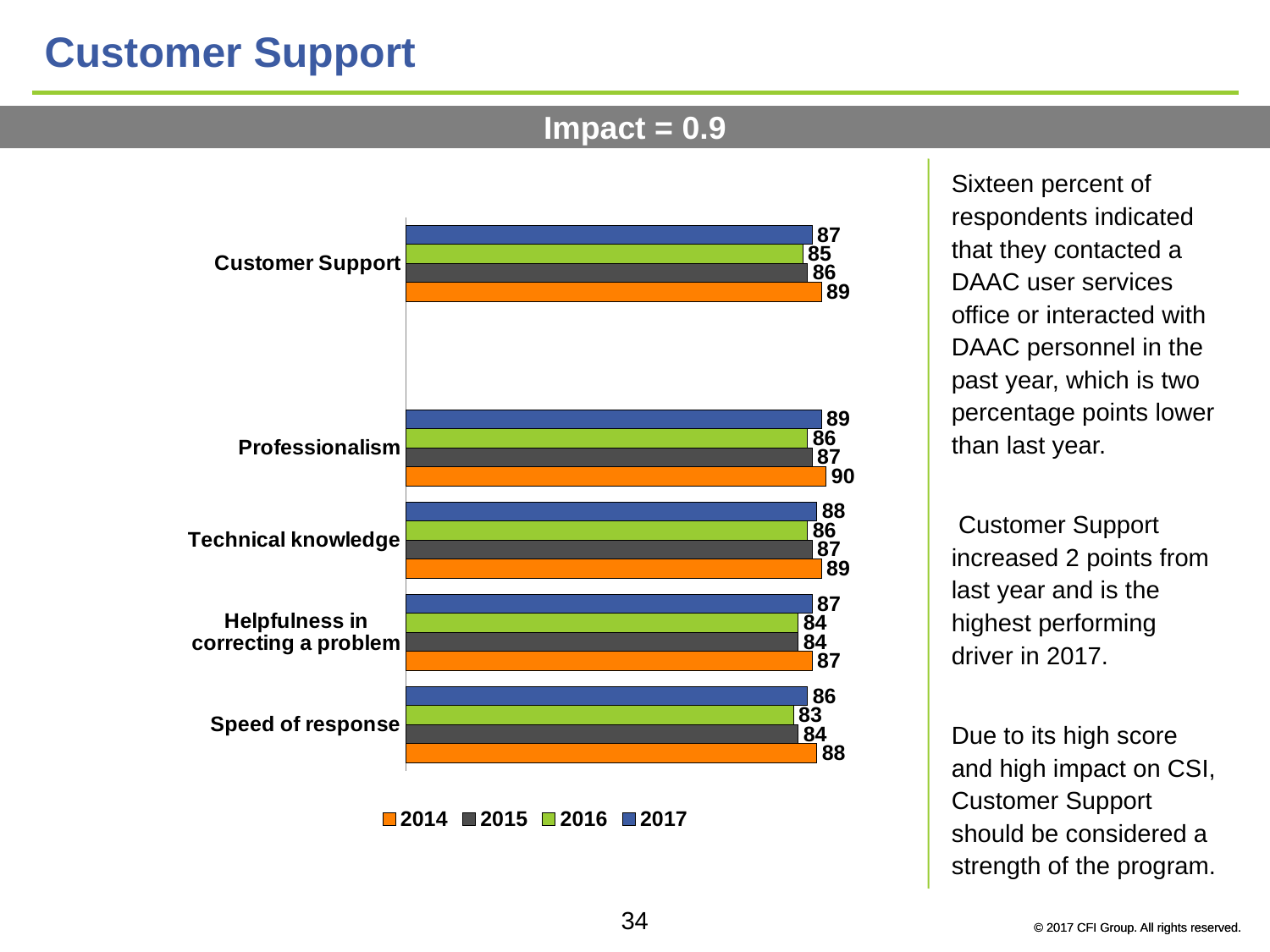
Which category has the highest 2017 value? Professionalism What is the 2014 value for Professionalism? 90 What impact value is shown in the banner above the chart? 0.9 How many series does the legend list? 4 Which is larger for Speed of response, the 2014 value or the 2017 value? 2014 What kind of chart is shown on the slide? Bar chart What is the difference between the 2017 and 2016 values for Helpfulness in correcting a problem? 3 How many categories are shown on the chart? 5 What is the 2015 value for Technical knowledge? 87 What is the 2017 value for Customer Support? 87 Which category has the lowest 2016 value? Speed of response What is the 2016 value for Speed of response? 83